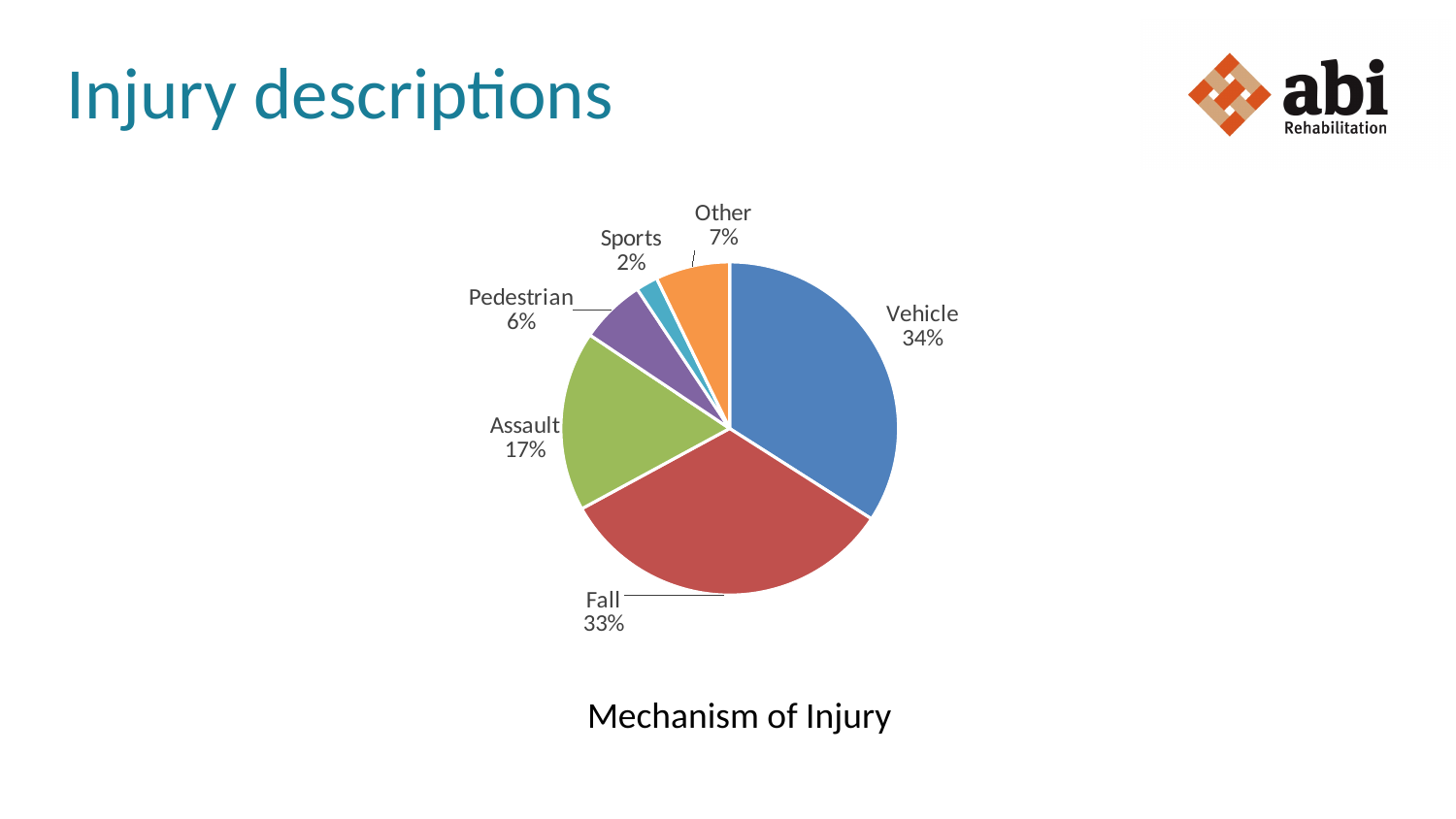
What percentage is shown for Assault? 17% What percentage is shown for Sports? 2% Which category has the largest slice of the pie? Vehicle What kind of chart is shown on the slide? Pie chart What is the difference in percentage points between Assault and Pedestrian? 11 Which category has the smallest slice of the pie? Sports What is the value shown for Fall? 33% How many categories are shown in the pie chart? 6 Which is larger, Other or Pedestrian? Other What share of the pie does Vehicle account for? 34% What is the title of the chart? Mechanism of Injury What is the value for Pedestrian? 6%